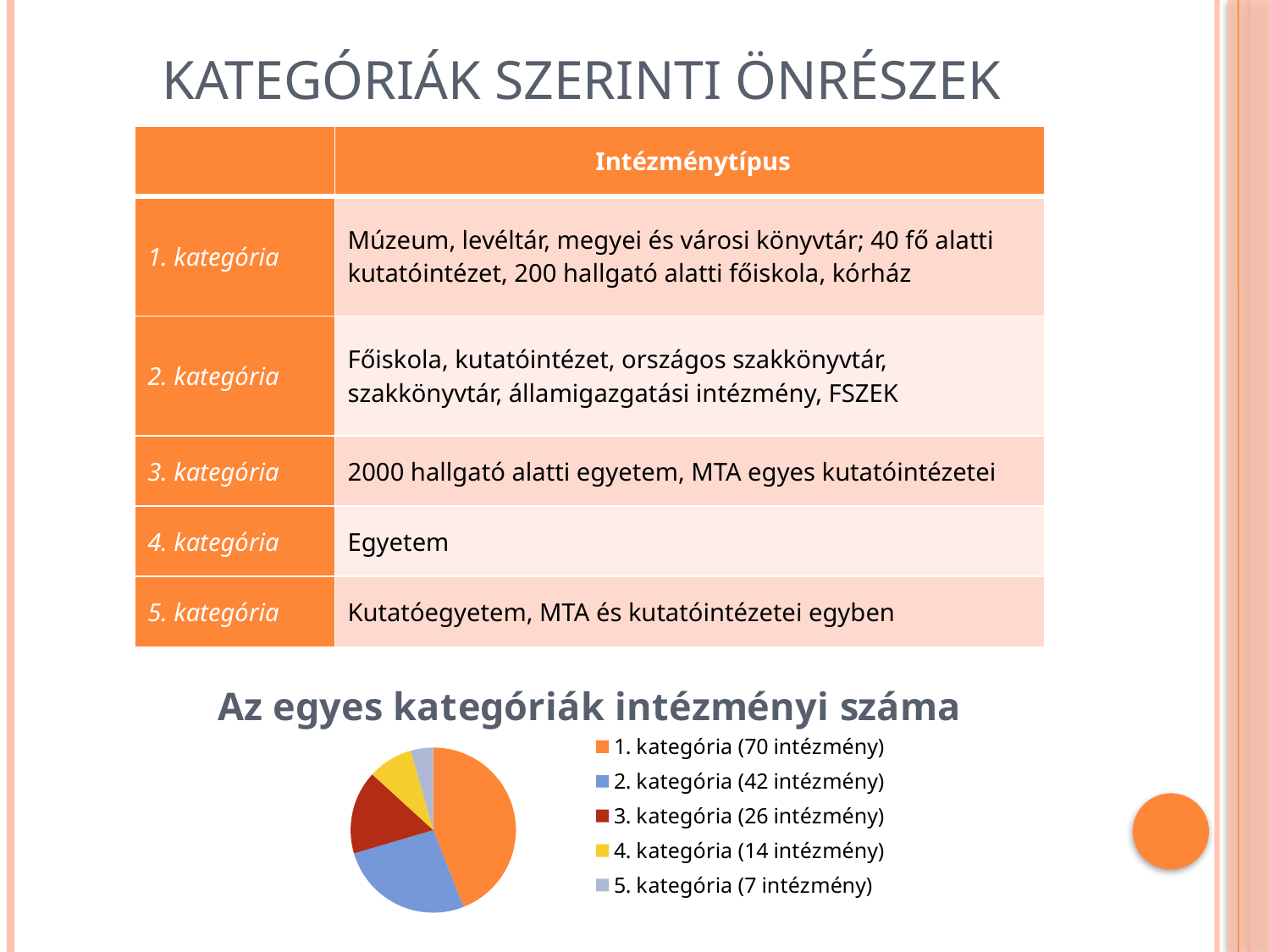
What kind of chart is shown on the slide? pie chart How many categories does the pie chart show? 5 How many institutions does the legend give for 1. kategória? 70 intézmény How many institutions does the legend give for 5. kategória? 7 intézmény How many institutions does the legend give for 3. kategória? 26 intézmény What is the title of the chart on the slide? Az egyes kategóriák intézményi száma Which colour represents 4. kategória in the pie chart? yellow Which category has the largest slice of the pie? 1. kategória What is the total number of institutions across all five categories in the pie chart? 159 What is the difference in the number of institutions between 1. kategória and 2. kategória? 28 Which has more institutions, 3. kategória or 4. kategória? 3. kategória Which category has the smallest slice of the pie? 5. kategória